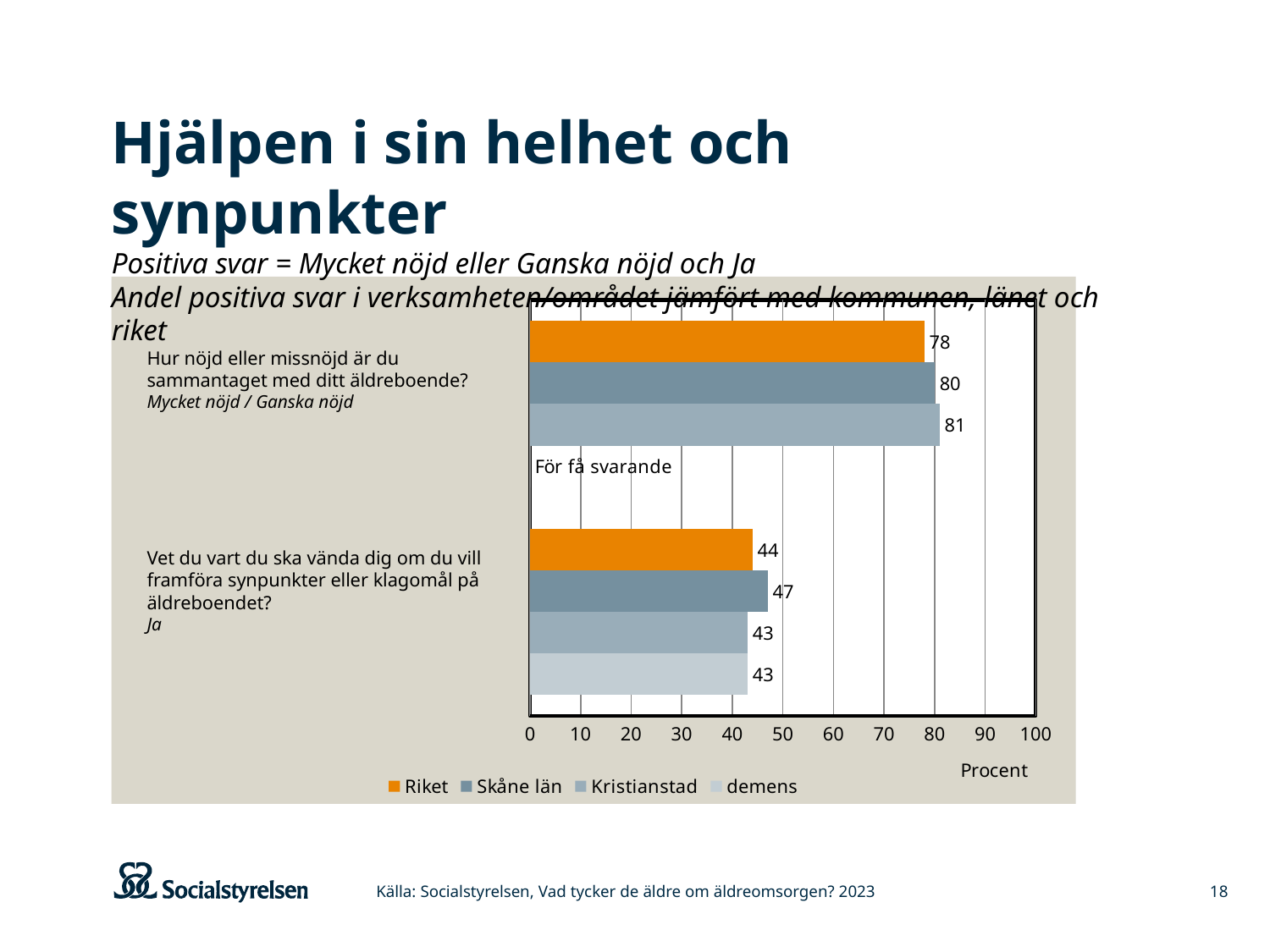
Which series has the lowest value on the question "Hur nöjd eller missnöjd är du sammantaget med ditt äldreboende?"? Riket What is the value for Riket on the question "Hur nöjd eller missnöjd är du sammantaget med ditt äldreboende?"? 78 Which series has the highest value on the question "Vet du vart du ska vända dig om du vill framföra synpunkter eller klagomål på äldreboendet?"? Skåne län What is the difference between Kristianstad and Riket on the question "Hur nöjd eller missnöjd är du sammantaget med ditt äldreboende?"? 3 What kind of chart is shown on the slide? bar chart What is the value for demens on the question "Vet du vart du ska vända dig om du vill framföra synpunkter eller klagomål på äldreboendet?"? 43 How many series does the legend list? 4 What is the value for Skåne län on the question "Vet du vart du ska vända dig om du vill framföra synpunkter eller klagomål på äldreboendet?"? 47 What is the label of the x axis? Procent What is the value for Kristianstad on the question "Hur nöjd eller missnöjd är du sammantaget med ditt äldreboende?"? 81 Which is larger on the question "Vet du vart du ska vända dig om du vill framföra synpunkter eller klagomål på äldreboendet?": Riket or Skåne län? Skåne län What is shown instead of a bar for demens on the question "Hur nöjd eller missnöjd är du sammantaget med ditt äldreboende?"? För få svarande